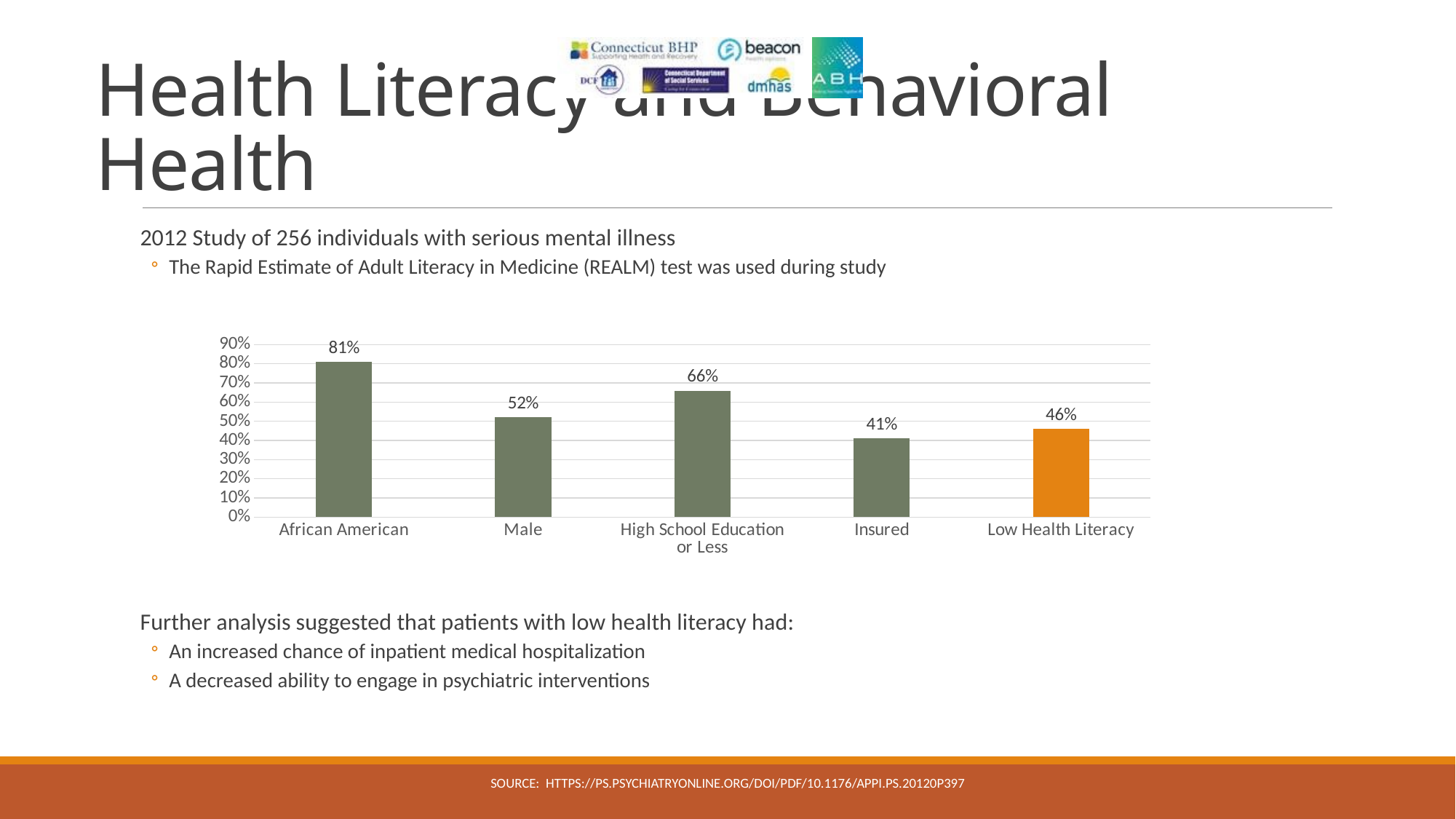
What is the value for Insured? 41% Which category has the highest value? African American What is the value for African American? 81% What is the value for Male? 52% Which is larger, the value for Male or the value for Low Health Literacy? Male What is the value for Low Health Literacy? 46% What is the value for High School Education or Less? 66% Which bar is coloured orange rather than green? Low Health Literacy What is the difference between the values for African American and Insured? 40% How many categories are shown in the chart? 5 What kind of chart is shown on the slide? Bar chart Which category has the lowest value? Insured